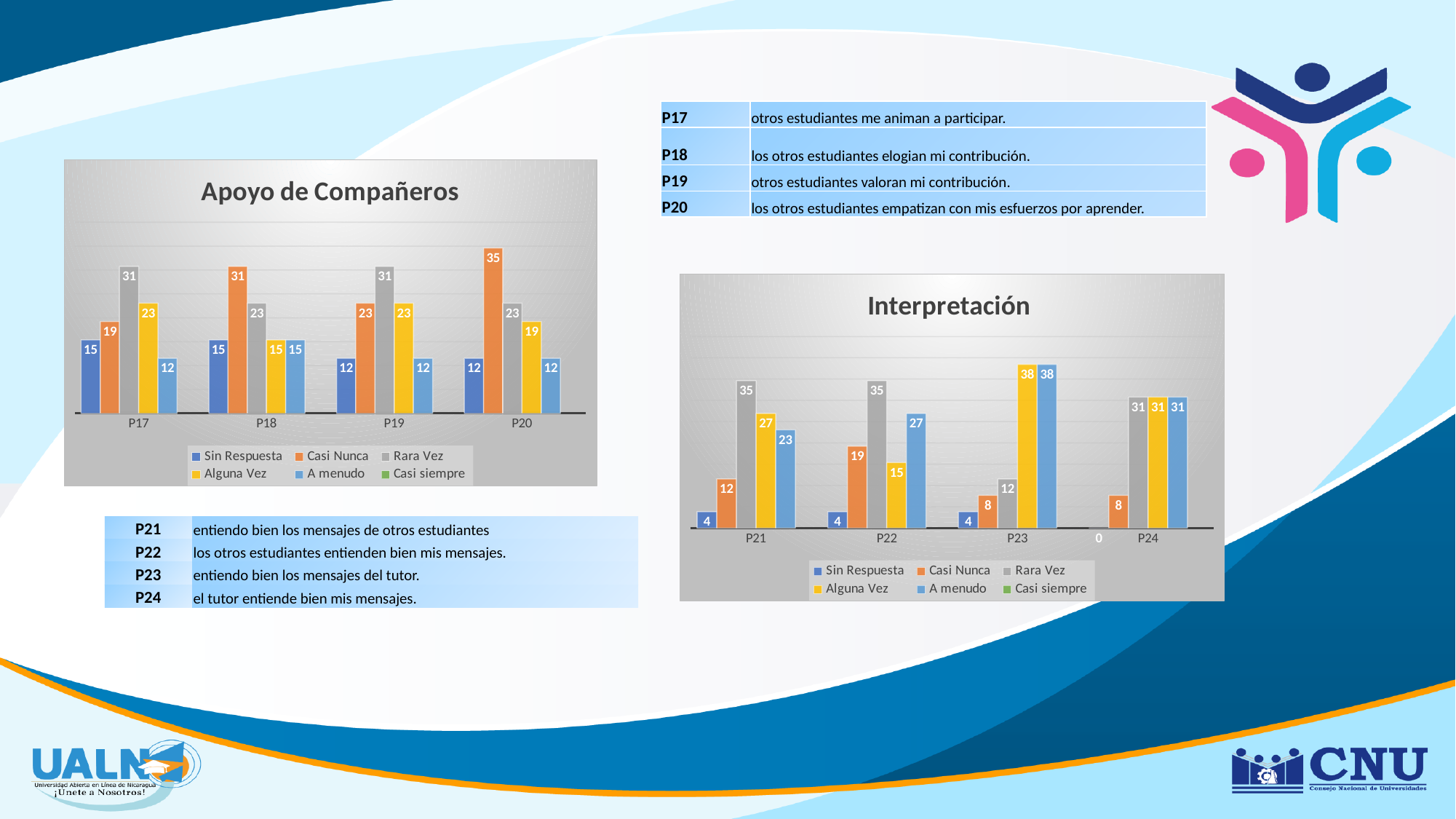
What type of chart is 'Apoyo de Compañeros'? Bar chart In the 'Apoyo de Compañeros' chart, what is the value of Rara Vez for P17? 31 In the 'Apoyo de Compañeros' chart, what is the difference between Rara Vez and A menudo for P19? 19 In the 'Interpretación' chart, what is the value of Casi Nunca for P22? 19 In the 'Apoyo de Compañeros' chart, which category has the highest Casi Nunca value? P20 In the 'Interpretación' chart, which is larger for P21: Alguna Vez or A menudo? Alguna Vez In the 'Apoyo de Compañeros' chart, how many categories are shown on the x axis? 4 In the 'Interpretación' chart, what is the value of Alguna Vez for P23? 38 In the 'Interpretación' chart, which category has the lowest Rara Vez value? P23 In the 'Apoyo de Compañeros' chart, what is the value of Casi Nunca for P20? 35 How many series does the legend of the 'Interpretación' chart list? 6 In the 'Interpretación' chart, what is the difference between Rara Vez and Casi Nunca for P21? 23